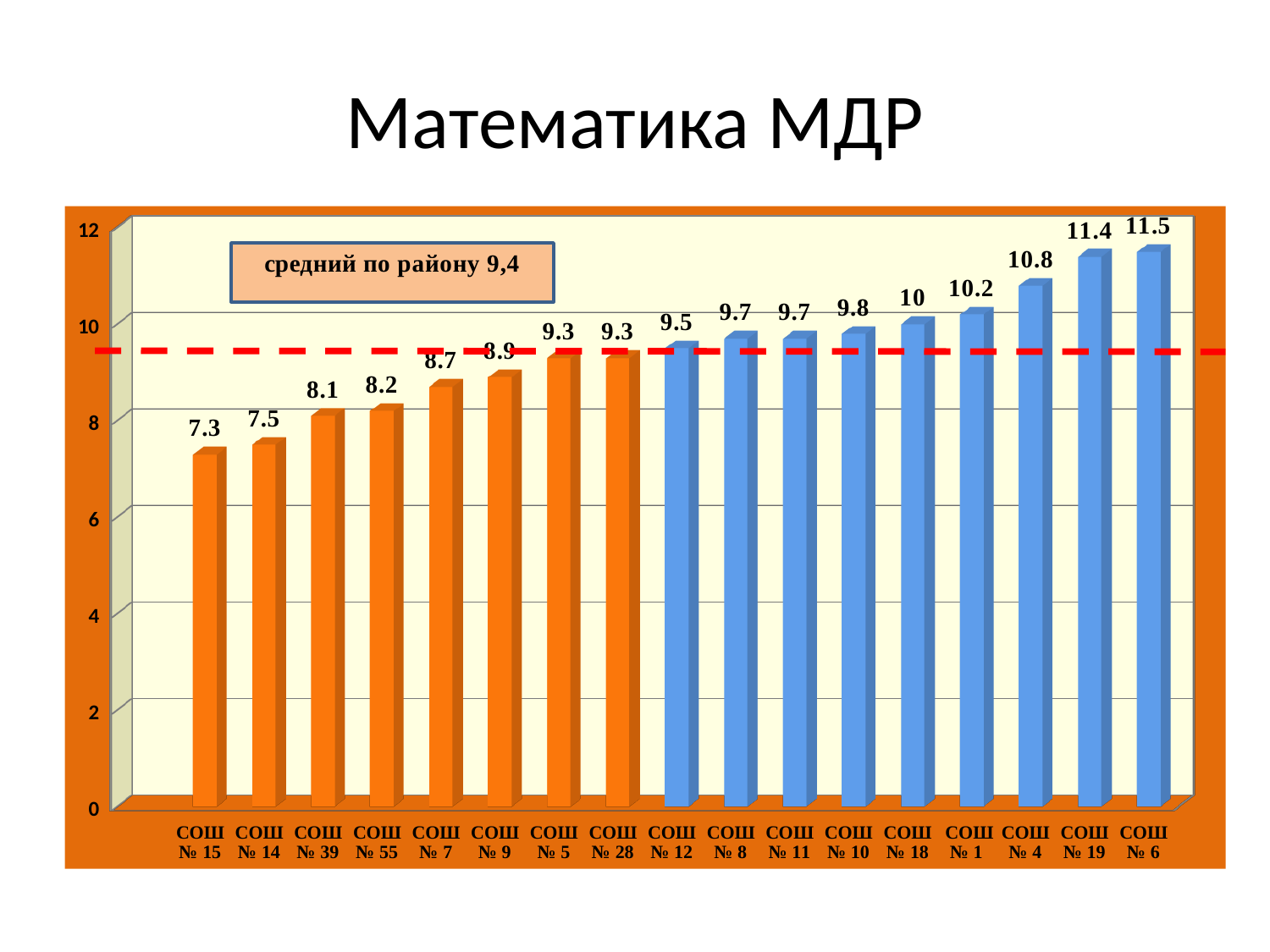
Which is larger, the value for СОШ № 39 or the value for СОШ № 7? СОШ № 7 What is the difference between the values for СОШ № 6 and СОШ № 15? 4.2 What is the value for СОШ № 4? 10.8 Is the value for СОШ № 14 greater or less than 8? less What is the value for СОШ № 15? 7.3 What district average value is shown in the box on the chart? 9,4 Which school has the lowest value? СОШ № 15 How many schools are shown on the chart? 17 What is the difference between the values for СОШ № 19 and СОШ № 1? 1.2 Which school has the highest value? СОШ № 6 What is the value for СОШ № 18? 10 What kind of chart is shown on the slide? bar chart